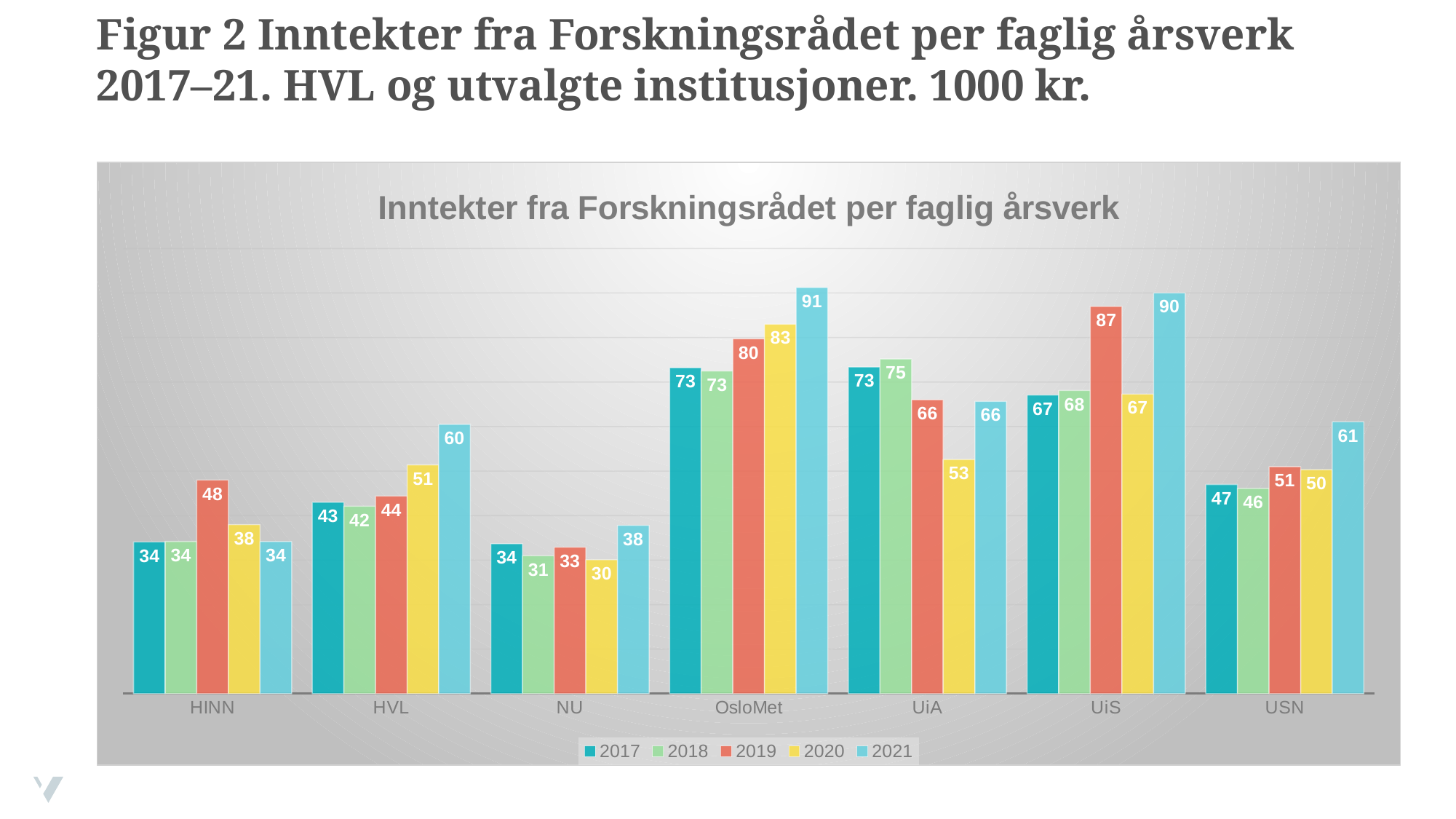
Which is larger: the 2019 value for UiA or the 2019 value for UiS? UiS Do the values for USN rise or fall from 2020 to 2021? rise What is the title of the chart? Inntekter fra Forskningsrådet per faglig årsverk How many institutions are shown on the x axis? 7 What is the value for HVL in 2021? 60 What kind of chart is shown? bar chart What is the difference between the 2021 and 2017 values for HVL? 17 What is the value for UiS in 2019? 87 Which institution has the highest value in 2021? OsloMet What is the value for NU in 2020? 30 How many series does the legend list? 5 Which institution has the lowest value in 2018? NU